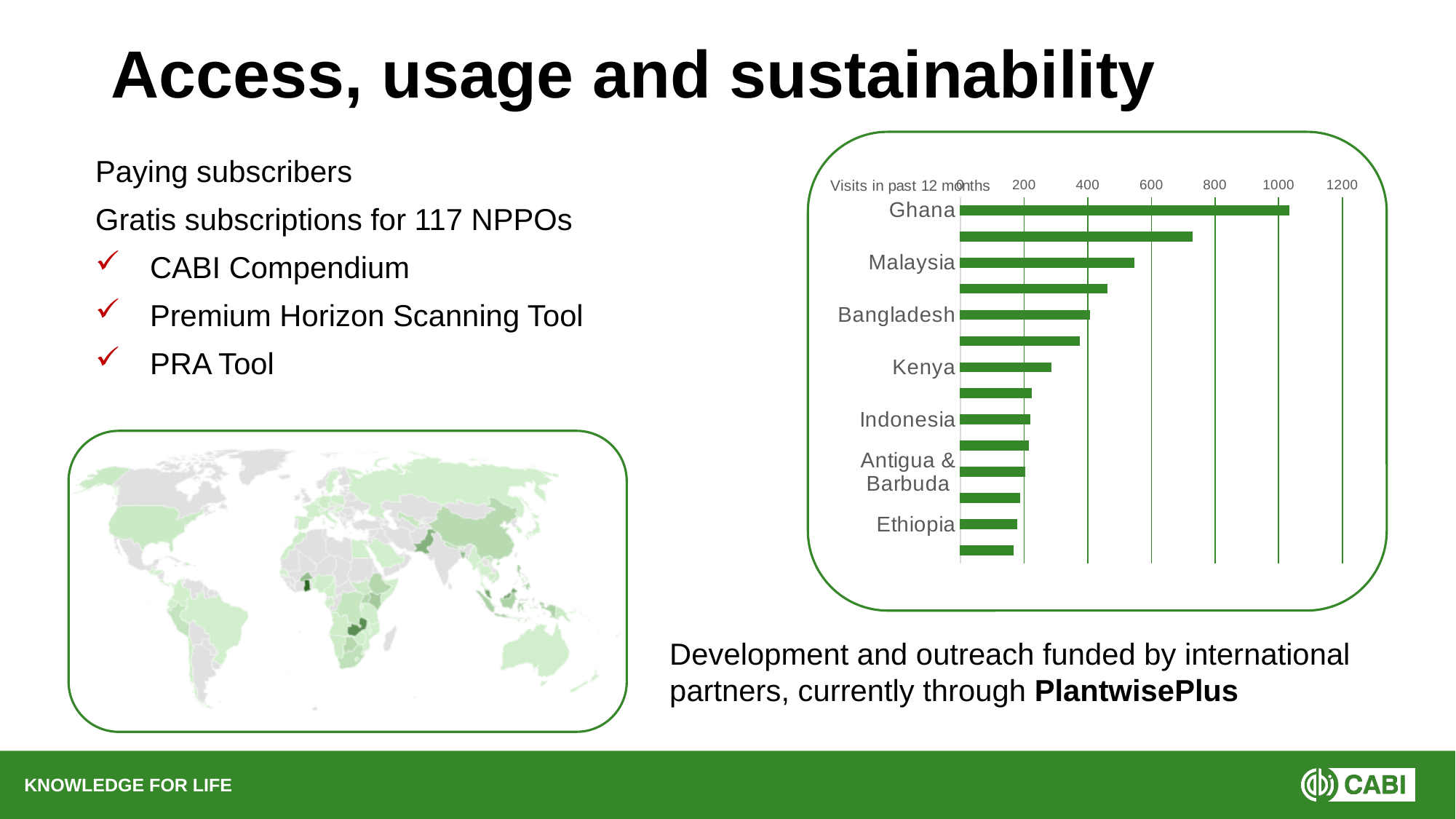
What kind of chart is shown on the right of the slide? Bar chart In the 'Visits in past 12 months' chart, is the value for Malaysia greater or less than 400? greater What is the highest tick value shown on the horizontal axis of the 'Visits in past 12 months' chart? 1200 How many bars are plotted in the 'Visits in past 12 months' chart? 14 In the 'Visits in past 12 months' chart, which labelled country has the highest number of visits? Ghana In the 'Visits in past 12 months' chart, is the value for Kenya greater or less than 400? less In the 'Visits in past 12 months' chart, do the bar values increase or decrease from the top of the chart to the bottom? Decrease In the 'Visits in past 12 months' chart, is the value for Ethiopia greater or less than 200? less In the 'Visits in past 12 months' chart, which has more visits, Kenya or Ethiopia? Kenya In the 'Visits in past 12 months' chart, which has more visits, Ghana or Malaysia? Ghana